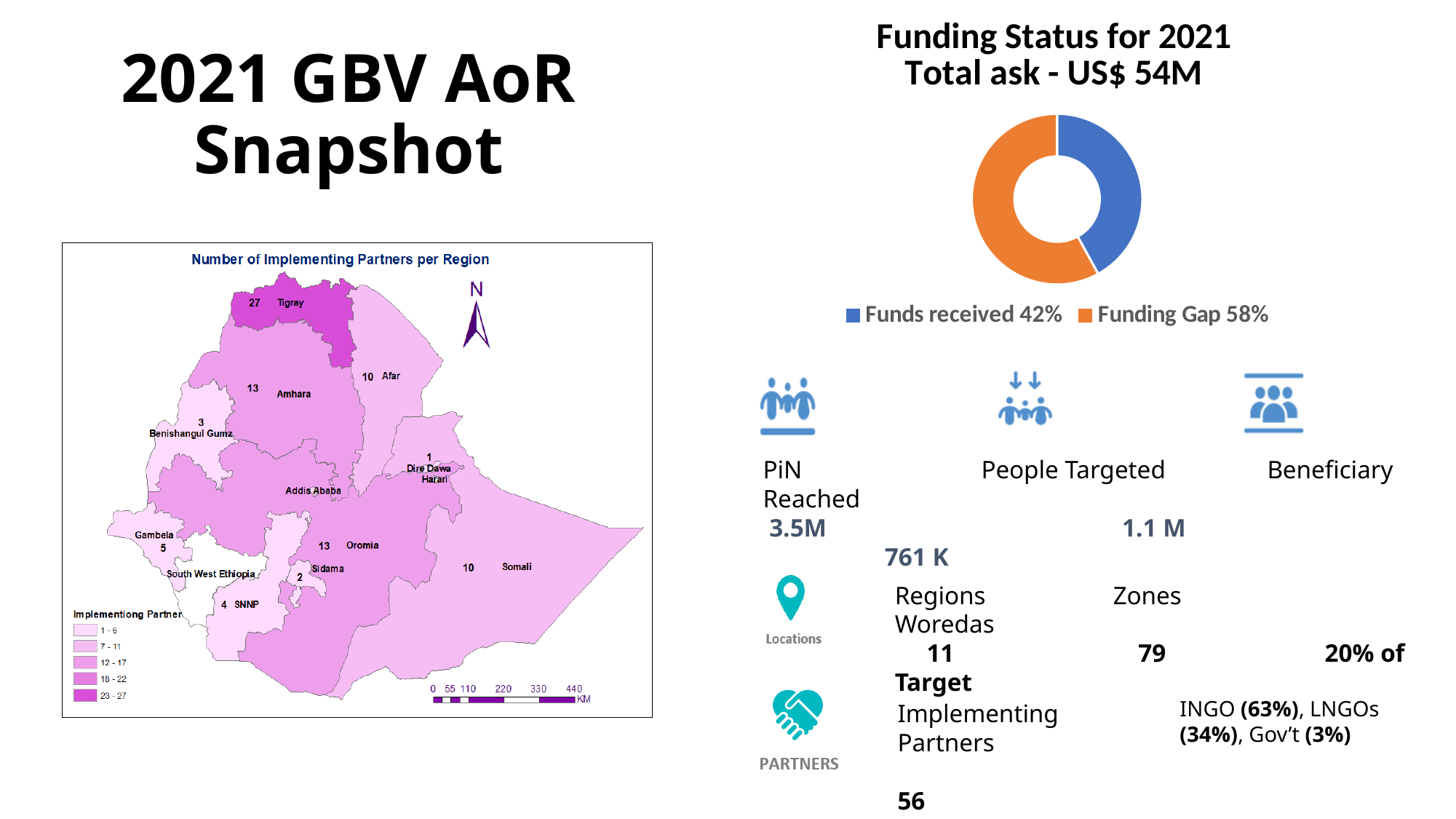
What kind of chart is the 'Funding Status for 2021' chart? Doughnut chart In the 'Funding Status for 2021' chart, what share is the Funding Gap? 58% What total ask is stated in the title of the 'Funding Status for 2021' chart? US$ 54M In the 'Funding Status for 2021' chart, what share is Funds received? 42% How many entries does the legend of the 'Funding Status for 2021' chart list? 2 In the 'Number of Implementing Partners per Region' map, which labelled region has the lowest number of implementing partners? Dire Dawa In the 'Number of Implementing Partners per Region' map, how many implementing partners are shown for Tigray? 27 In the 'Funding Status for 2021' chart, which slice is larger, Funds received or Funding Gap? Funding Gap In the 'Number of Implementing Partners per Region' map, what is the difference between the number of implementing partners in Tigray and in Amhara? 14 In the 'Funding Status for 2021' chart, what is the difference in percentage points between the Funding Gap and Funds received? 16 In the 'Number of Implementing Partners per Region' map, which labelled region has the highest number of implementing partners? Tigray In the 'Funding Status for 2021' chart, what colour is the Funding Gap slice? Orange